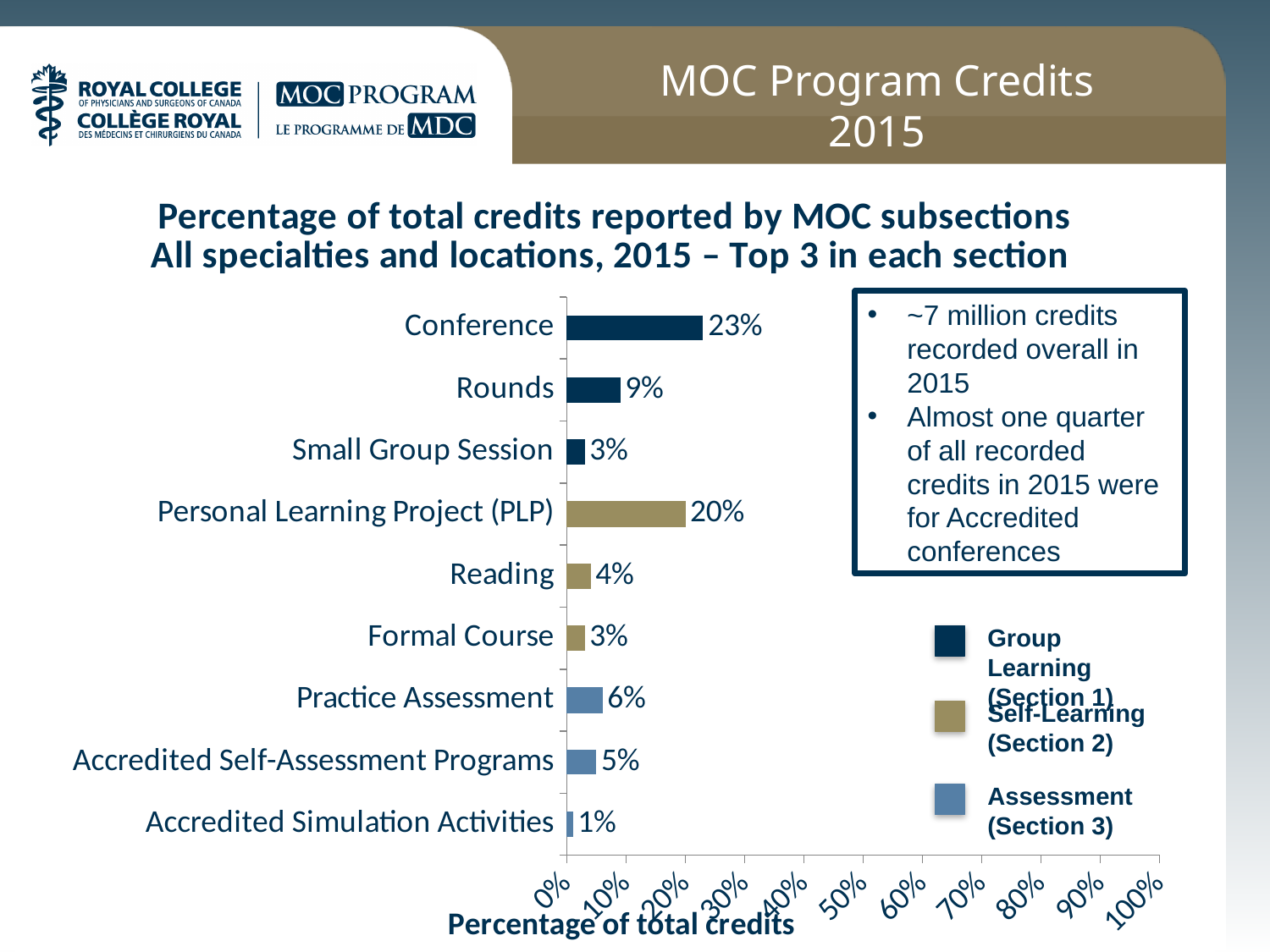
What is the difference between the percentages for Conference and Rounds? 14% Which category has the highest percentage of total credits? Conference What percentage of total credits is shown for Conference? 23% What kind of chart is shown on the slide? Bar chart What is the difference between the percentages for Practice Assessment and Accredited Simulation Activities? 5% What is the label of the horizontal axis of the chart? Percentage of total credits Which category has the lowest percentage of total credits? Accredited Simulation Activities How many categories are shown in the chart? 9 What percentage of total credits is shown for Accredited Self-Assessment Programs? 5% Which has a larger percentage of total credits, Reading or Practice Assessment? Practice Assessment Is the value for Personal Learning Project (PLP) greater or less than 10%? greater What percentage of total credits is shown for Personal Learning Project (PLP)? 20%